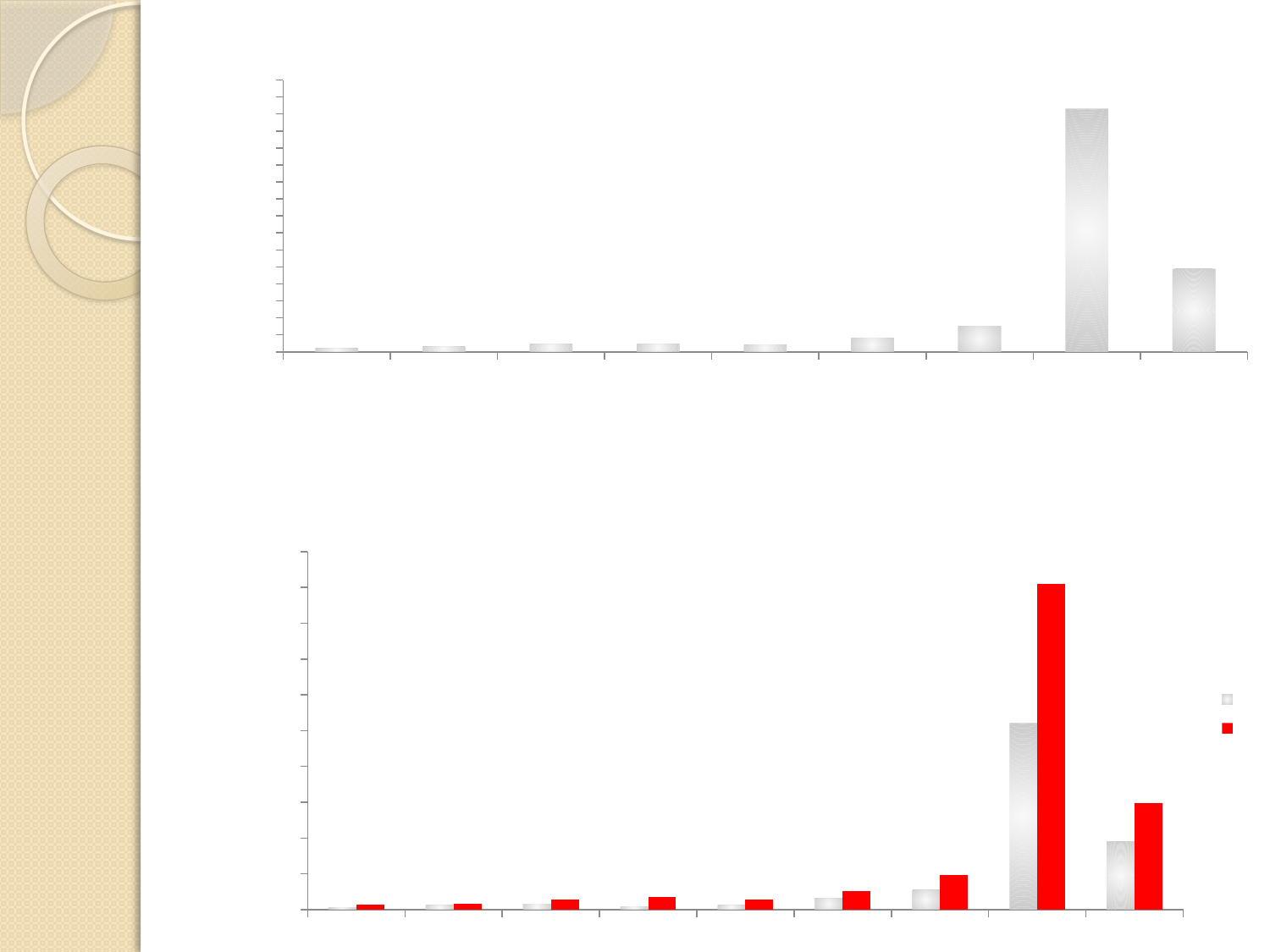
What kind of chart is the top chart on the slide? bar chart How many series are plotted in the top chart? 1 Does the top chart have a legend? No How many categories are plotted along the x axis of the bottom chart? 9 How many bars are plotted in the top chart? 9 In the bottom chart, counting from the left, which category has the tallest bars? the eighth category In the bottom chart, which series has the taller bar in the eighth category from the left, the grey series or the red series? the red series In the bottom chart, what two colours are used for the two series? grey and red In the top chart, is the eighth bar from the left taller or shorter than the ninth bar? taller In the top chart, counting from the left, which bar is the tallest? the eighth bar How many series does the legend of the bottom chart list? 2 What kind of chart is the bottom chart on the slide? bar chart